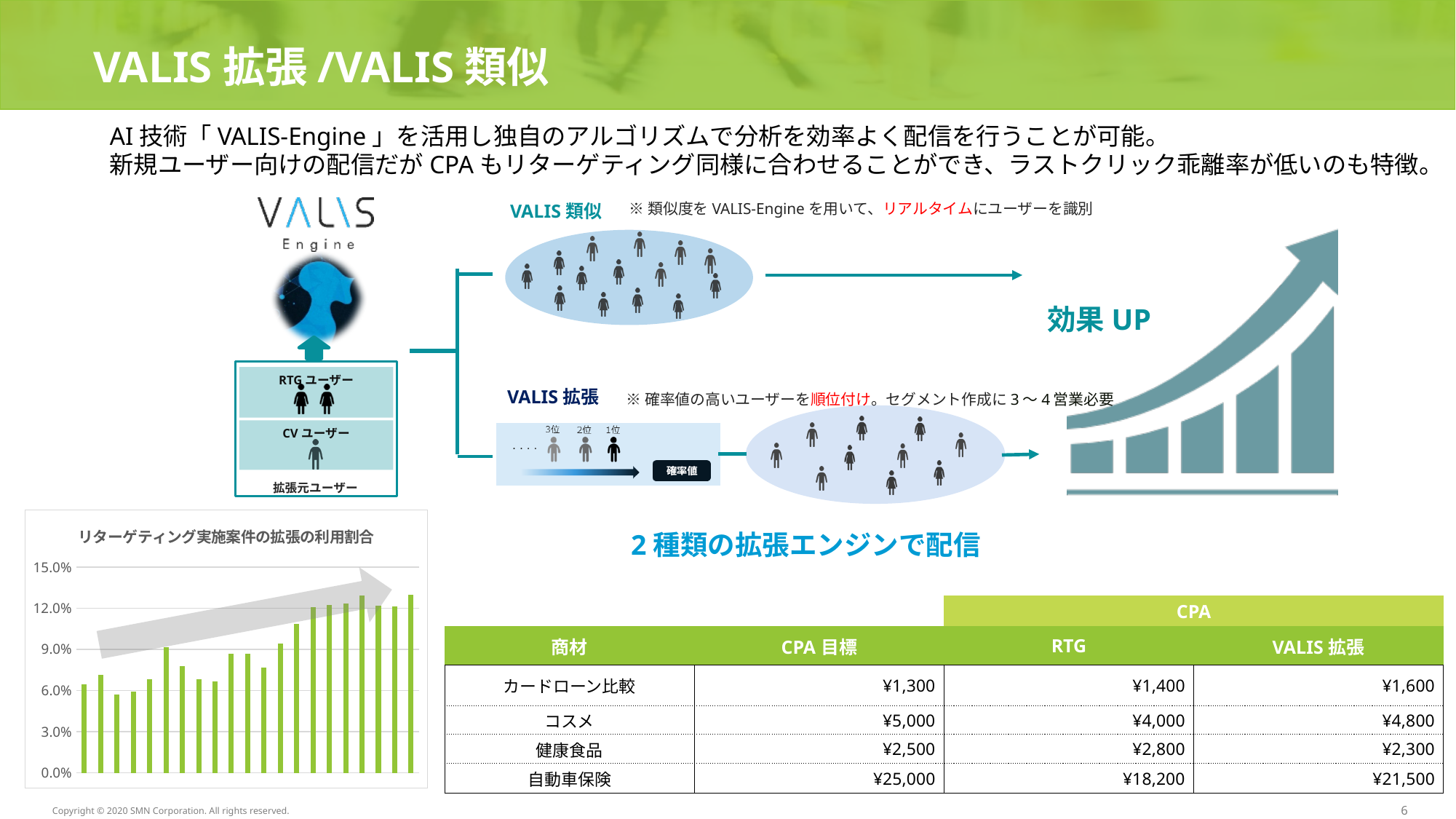
In the bar chart, is the value of the rightmost bar greater or less than 12.0%? greater What is the highest value shown on the y axis of the bar chart? 15.0% What kind of chart is shown at the bottom left of the slide? bar chart In the bar chart, does any bar exceed 15.0%? No In the bar chart, is the value of the leftmost bar greater or less than 9.0%? less In the bar chart, do the values generally rise or fall from left to right? rise In the bar chart, which is larger, the leftmost bar or the rightmost bar? the rightmost bar What is the title of the bar chart at the bottom left of the slide? リターゲティング実施案件の拡張の利用割合